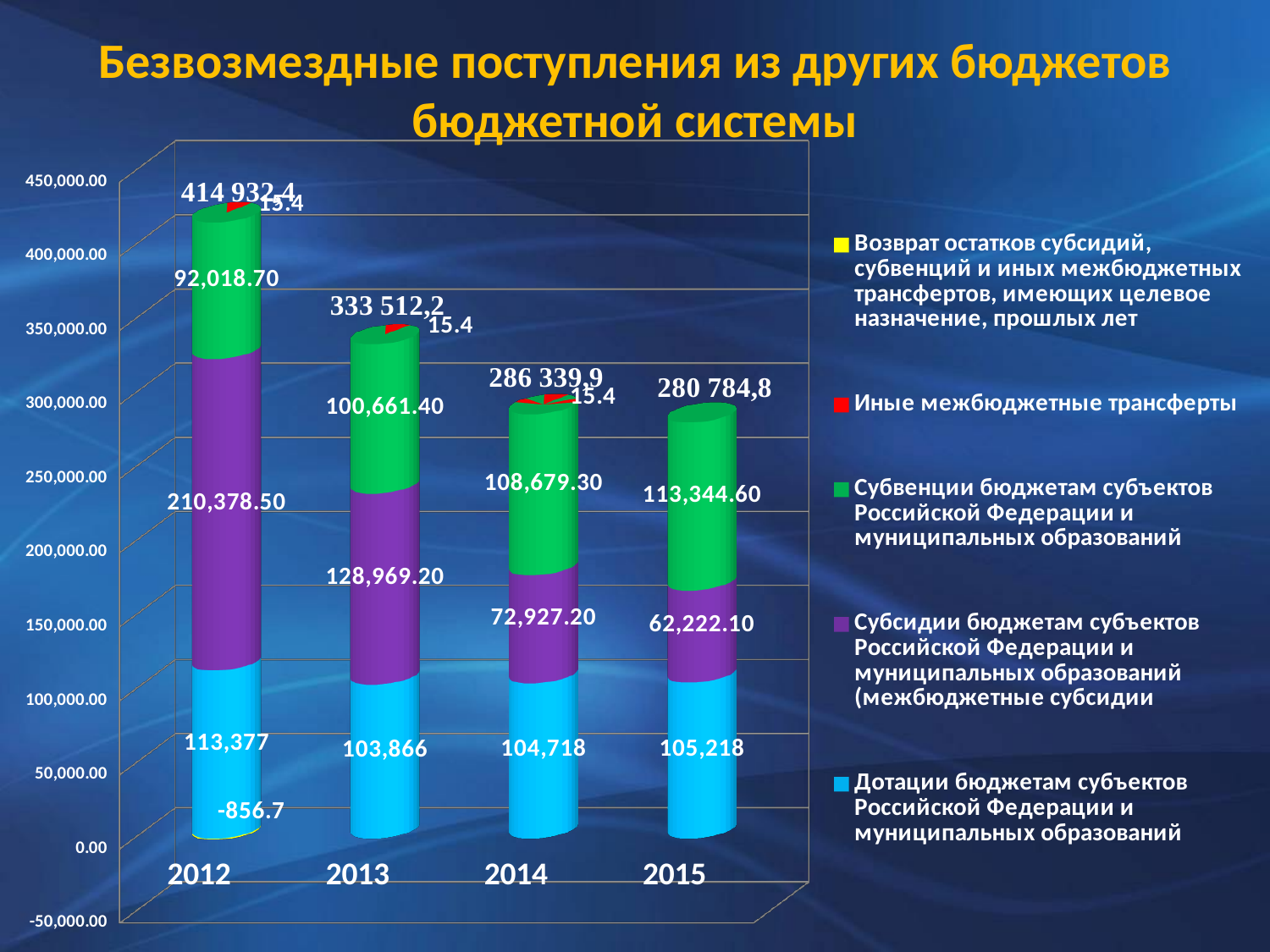
What is the value of Дотации бюджетам субъектов Российской Федерации и муниципальных образований for 2012? 113,377 Which is larger, the Субвенции value for 2013 or for 2014? 2014 What is the value of Субвенции бюджетам субъектов Российской Федерации и муниципальных образований for 2015? 113,344.60 How many years are shown on the x axis? 4 What type of chart is shown on the slide? stacked bar chart How many series does the legend list? 5 What is the difference between the Субсидии values for 2012 and 2015? 148,156.40 What is the total labelled above the 2014 bar? 286 339,9 Which year has the lowest total? 2015 What is the value of Субсидии бюджетам субъектов Российской Федерации и муниципальных образований for 2013? 128,969.20 Which year has the highest total? 2012 Do the bar totals rise or fall from 2012 to 2015? fall